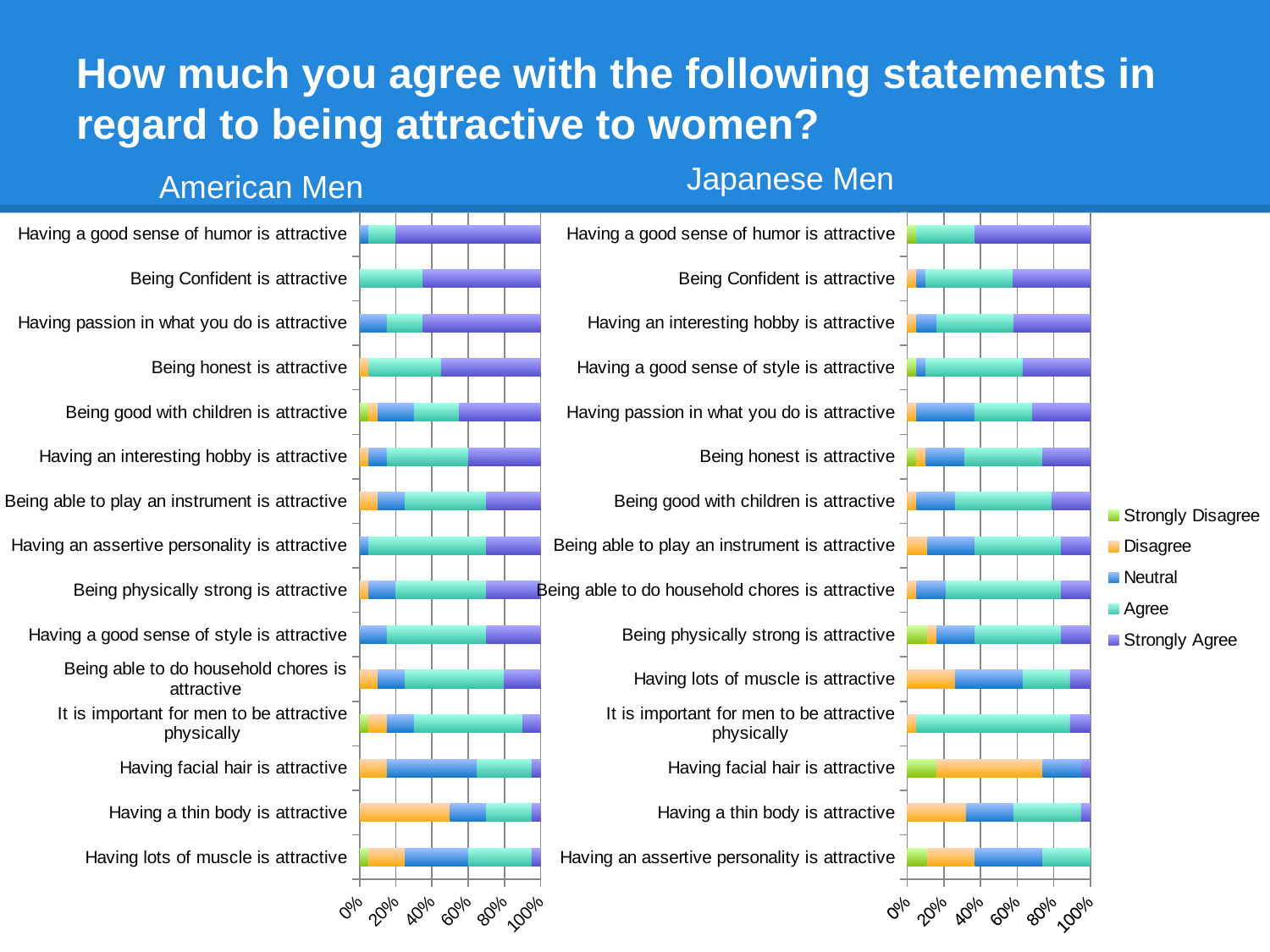
In the Japanese Men chart, which is larger for 'Having facial hair is attractive': the Disagree share or the Strongly Agree share? Disagree How many statements (categories) are plotted in the Japanese Men chart? 15 In the American Men chart, which is larger for 'Having a good sense of humor is attractive': the Agree share or the Strongly Agree share? Strongly Agree In the American Men chart, is the Strongly Agree share for 'Having a good sense of humor is attractive' greater or less than 60%? greater In the American Men chart, which statement has the largest Strongly Agree share? Having a good sense of humor is attractive In the Japanese Men chart, is the Disagree share for 'Having facial hair is attractive' greater or less than 40%? greater How many statements (categories) are plotted in the American Men chart? 15 In the Japanese Men chart, is the Strongly Agree share for 'Having a good sense of humor is attractive' greater or less than 40%? greater Which legend entry is shown in green? Strongly Disagree How many series does the legend list for the charts? 5 In the Japanese Men chart, which statement has the largest Strongly Agree share? Having a good sense of humor is attractive What kind of chart is the American Men chart? Stacked bar chart